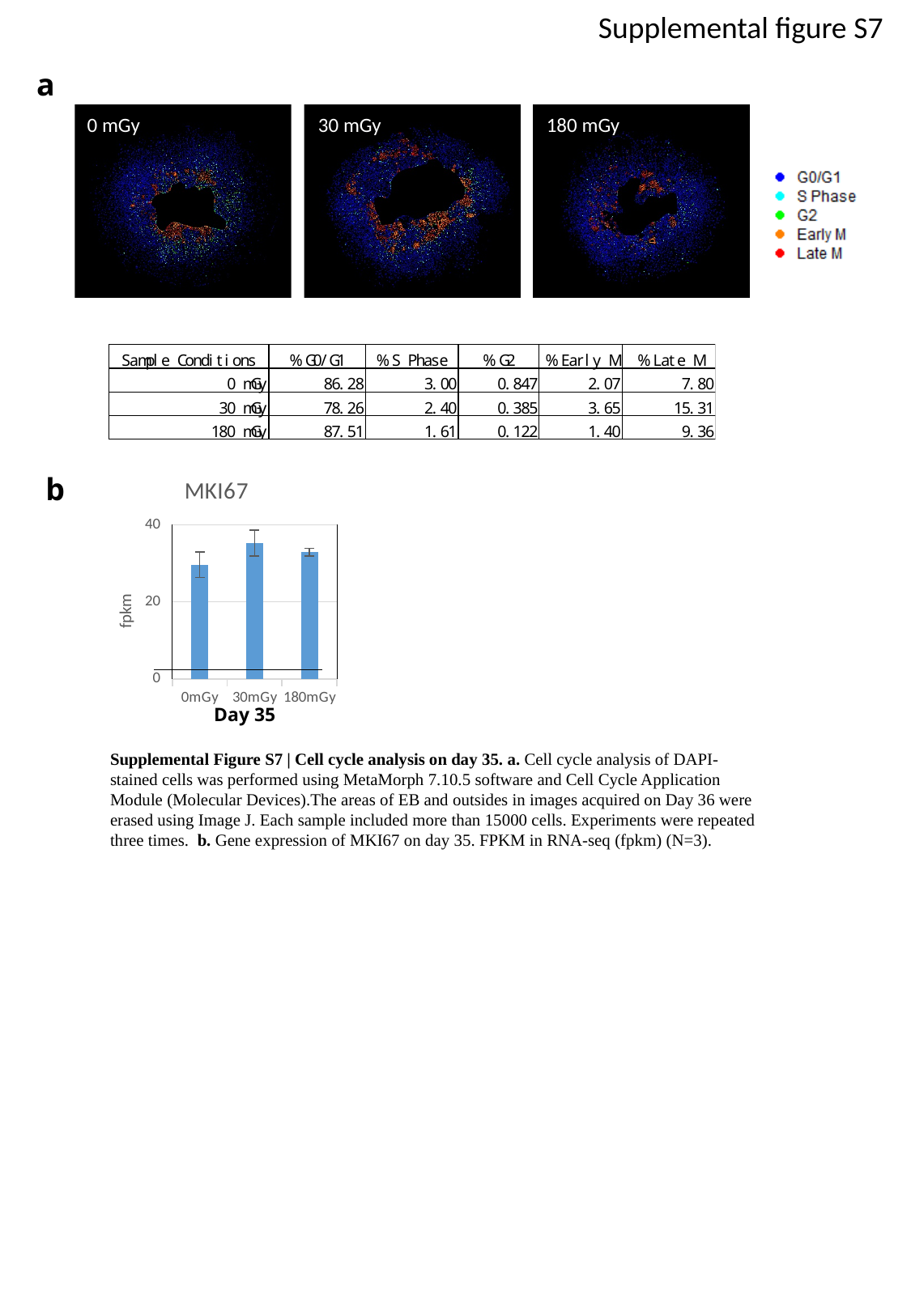
In the MKI67 chart, which condition has the lowest bar? 0mGy In the MKI67 chart, is the value for 30mGy greater or less than 40? less In the MKI67 chart, is the value for 0mGy greater or less than 20? greater What is the title of the chart in panel b? MKI67 What is the y-axis label of the MKI67 chart? fpkm In the MKI67 chart, which is larger, the value for 0mGy or the value for 30mGy? 30mGy What kind of chart is shown in panel b? bar chart How many bars are plotted in the MKI67 chart? 3 In the MKI67 chart, is the value for 180mGy greater or less than 20? greater In the MKI67 chart, which is larger, the value for 0mGy or the value for 180mGy? 180mGy In the MKI67 chart, which condition has the highest bar? 30mGy